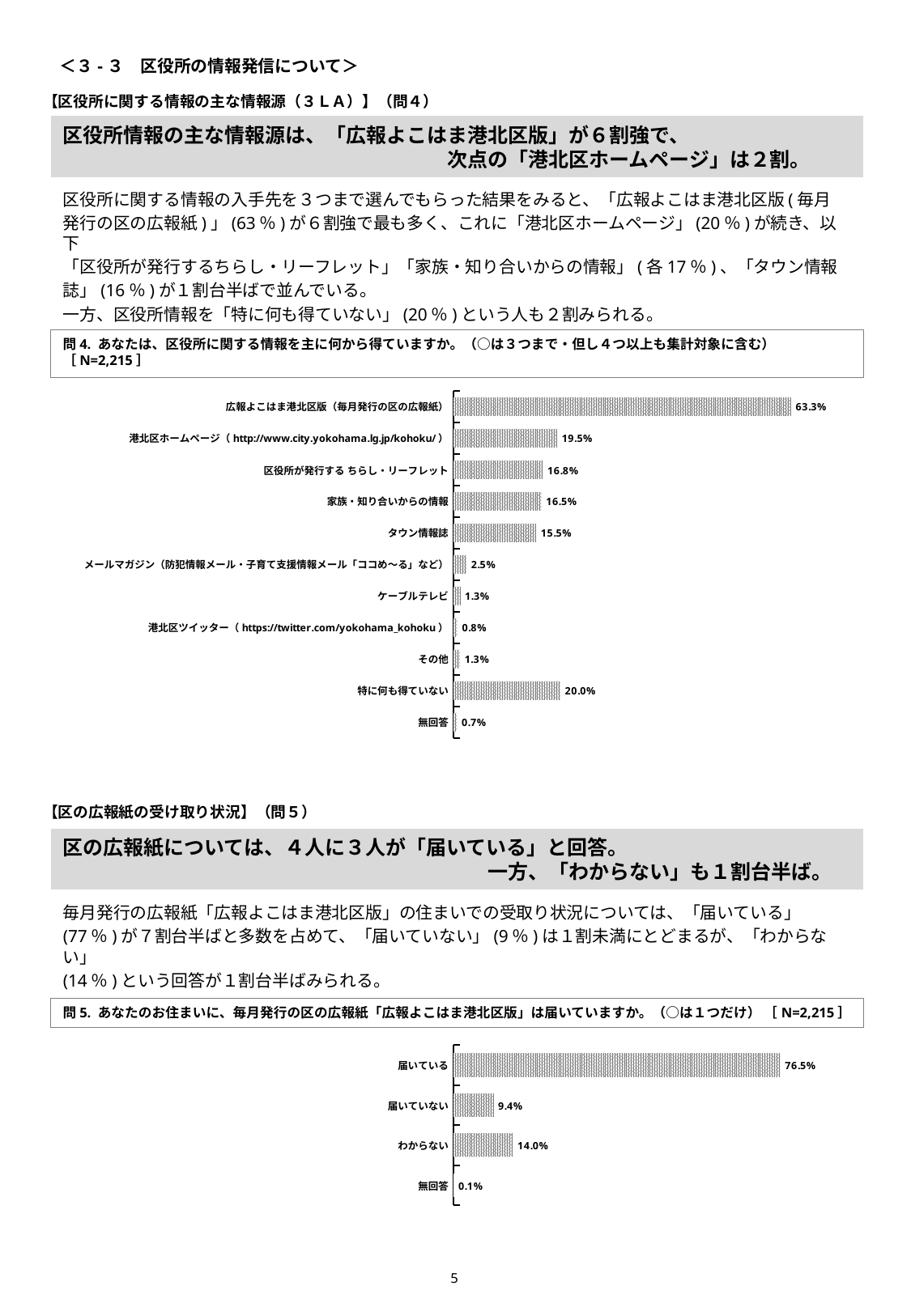
In the top chart (問4), what is the value for 広報よこはま港北区版（毎月発行の区の広報紙）? 63.3% In the bottom chart (問5), what is the value for 届いている? 76.5% What kind of chart is the top chart (問4)? bar chart How many categories are shown in the top chart (問4)? 11 How many categories are shown in the bottom chart (問5)? 4 In the bottom chart (問5), what is the difference between 届いている and 届いていない? 67.1% In the top chart (問4), what is the difference between 港北区ホームページ and タウン情報誌? 4.0% In the bottom chart (問5), what is the value for わからない? 14.0% In the top chart (問4), which category has the highest value? 広報よこはま港北区版（毎月発行の区の広報紙） In the top chart (問4), which is larger: 家族・知り合いからの情報 or メールマガジン? 家族・知り合いからの情報 In the top chart (問4), which category has the lowest value? 無回答 In the top chart (問4), what is the value for 特に何も得ていない? 20.0%